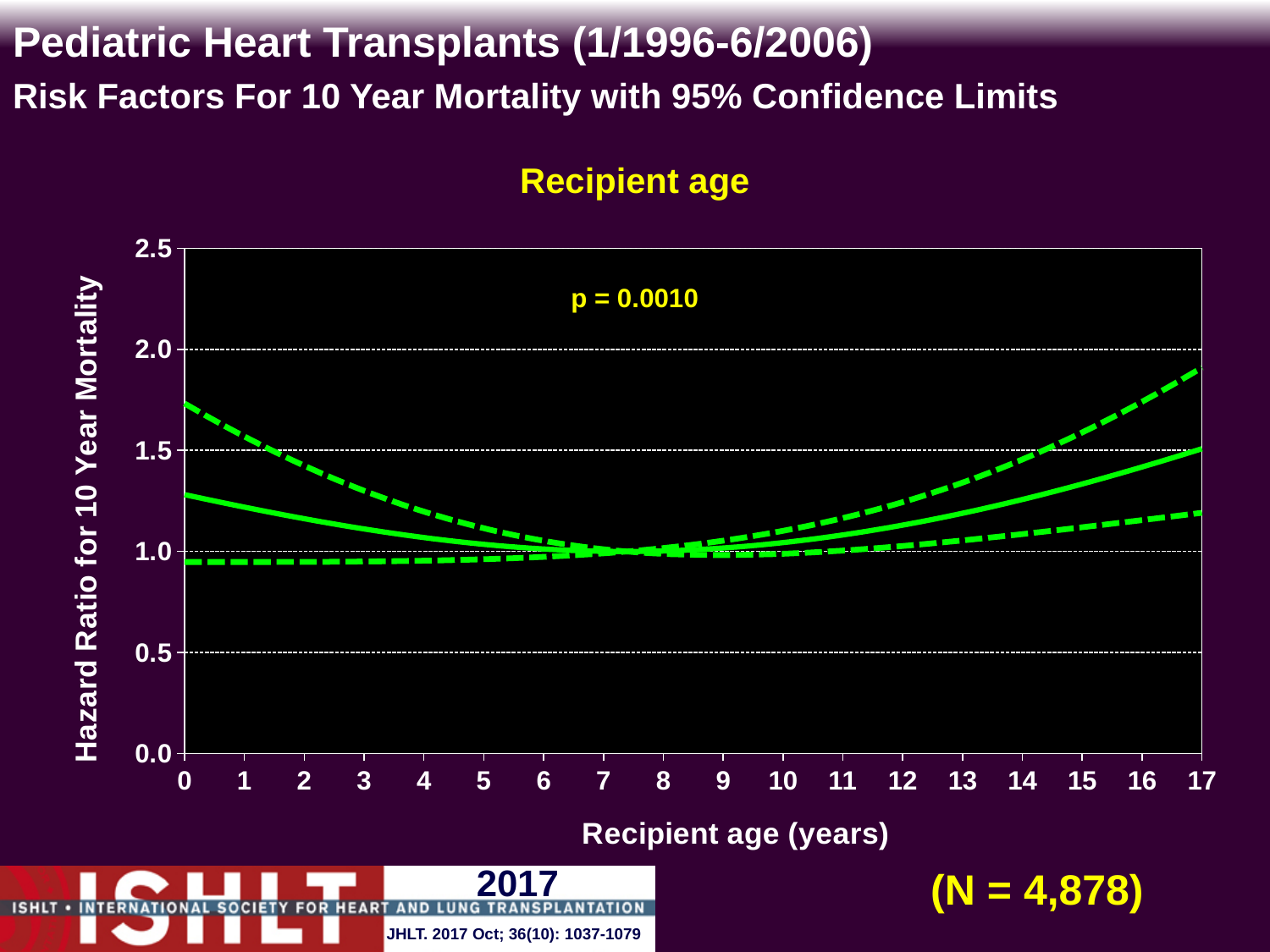
Does the hazard ratio (solid line) rise or fall as recipient age increases from 8 to 17 years? rise How many lines are plotted on the chart? 3 Is the hazard ratio (solid line) larger at recipient age 17 or at recipient age 0? age 17 Is the hazard ratio (solid line) at recipient age 0 greater or less than 1.0? greater Is the hazard ratio (solid line) at recipient age 17 greater or less than 2.0? less Does the hazard ratio (solid line) rise or fall as recipient age increases from 0 to 8 years? fall What kind of chart is shown on the slide? line chart Is the upper confidence limit (upper dashed line) at recipient age 17 greater or less than 1.5? greater What p-value is printed on the chart? p = 0.0010 What sample size (N) is shown on the slide? N = 4,878